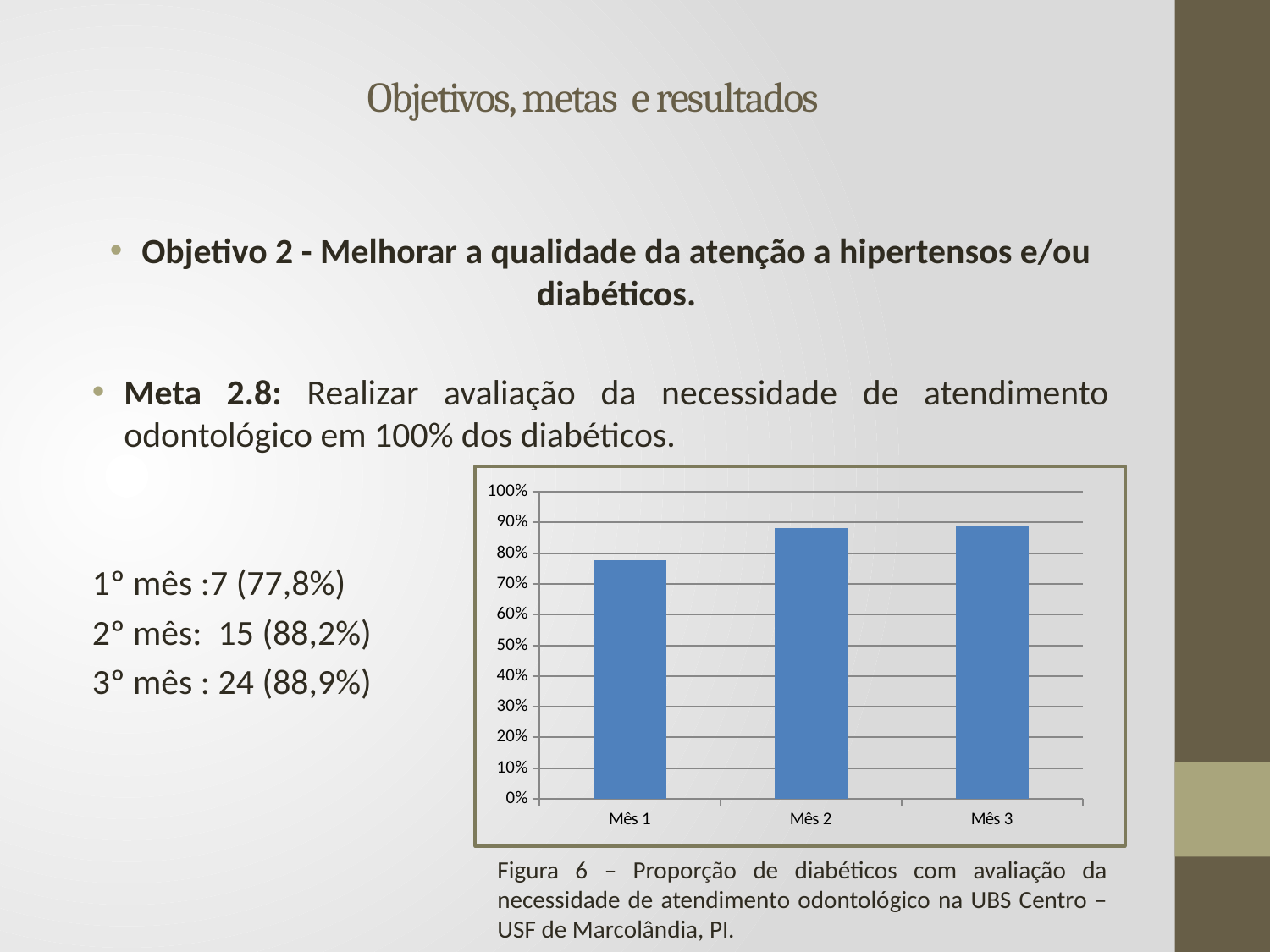
What kind of chart is shown on the slide? bar chart According to the text on the slide, what percentage corresponds to the 3° mês? 88,9% How many months (categories) are plotted on the x axis of the chart? 3 Is the value for Mês 2 greater or less than 80%? greater Is the value for Mês 1 greater or less than 80%? less Do the values rise or fall from Mês 1 to Mês 3? rise Which month has the lowest bar in the chart? Mês 1 According to the text on the slide, what percentage corresponds to the 1° mês? 77,8% What is the figure number given in the caption below the chart? Figura 6 Is the value for Mês 1 greater or less than 70%? greater Which is larger, the value for Mês 1 or the value for Mês 2? Mês 2